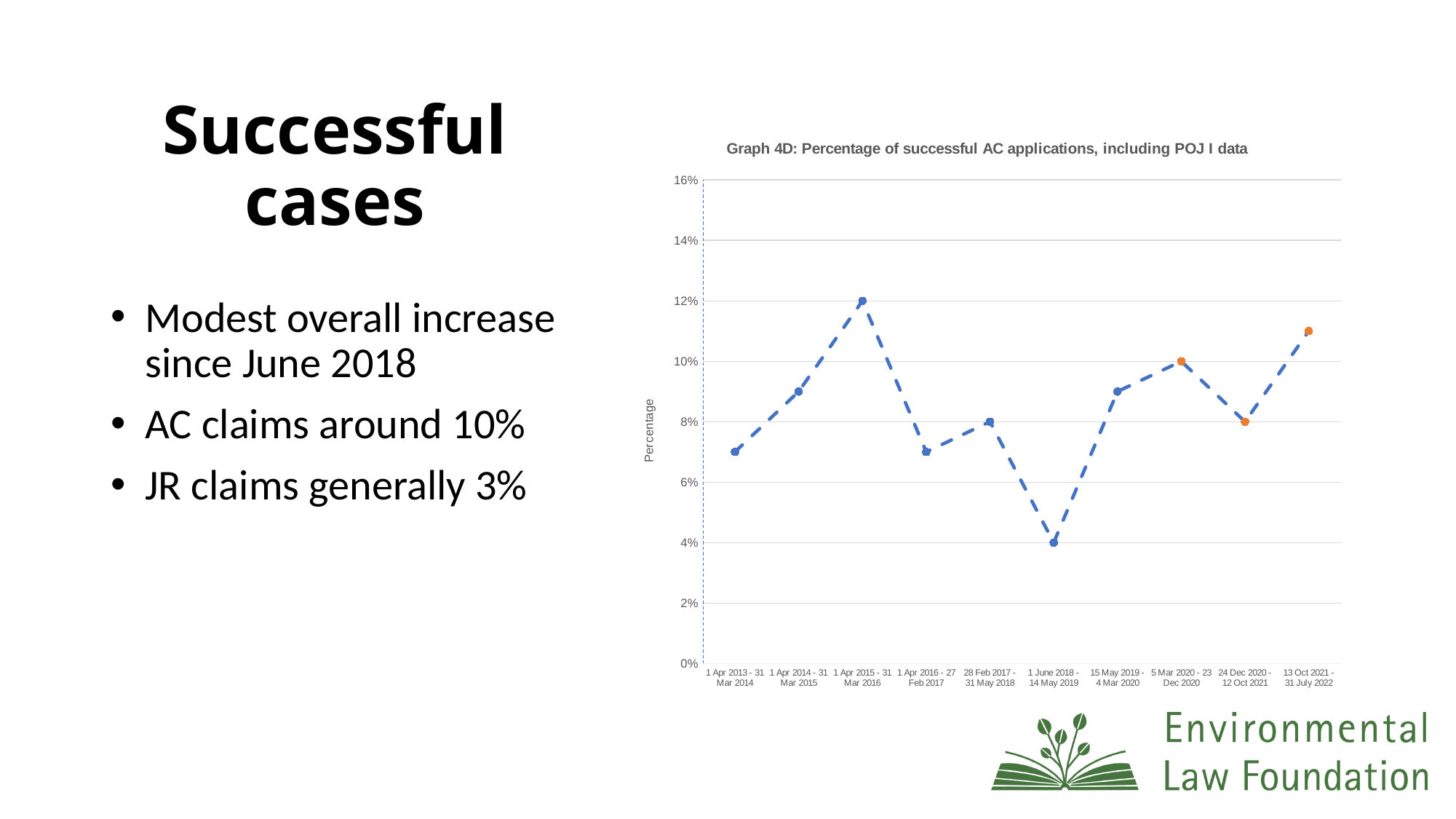
What is the percentage of successful AC applications for the period 1 June 2018 - 14 May 2019? 4% What is the difference between the percentage for 1 Apr 2015 - 31 Mar 2016 and the percentage for 1 June 2018 - 14 May 2019? 8% Which period has the lowest percentage of successful AC applications? 1 June 2018 - 14 May 2019 What type of chart is shown on the slide? line chart What is the percentage of successful AC applications for the period 24 Dec 2020 - 12 Oct 2021? 8% How many time periods are plotted along the x axis of the chart? 10 Which period has the highest percentage of successful AC applications? 1 Apr 2015 - 31 Mar 2016 Is the value for 13 Oct 2021 - 31 July 2022 greater or less than 10%? greater What is the title of the chart? Graph 4D: Percentage of successful AC applications, including POJ I data What is the percentage of successful AC applications for the period 5 Mar 2020 - 23 Dec 2020? 10% What is the percentage of successful AC applications for the period 1 Apr 2015 - 31 Mar 2016? 12% Which is larger: the value for 5 Mar 2020 - 23 Dec 2020 or the value for 24 Dec 2020 - 12 Oct 2021? 5 Mar 2020 - 23 Dec 2020